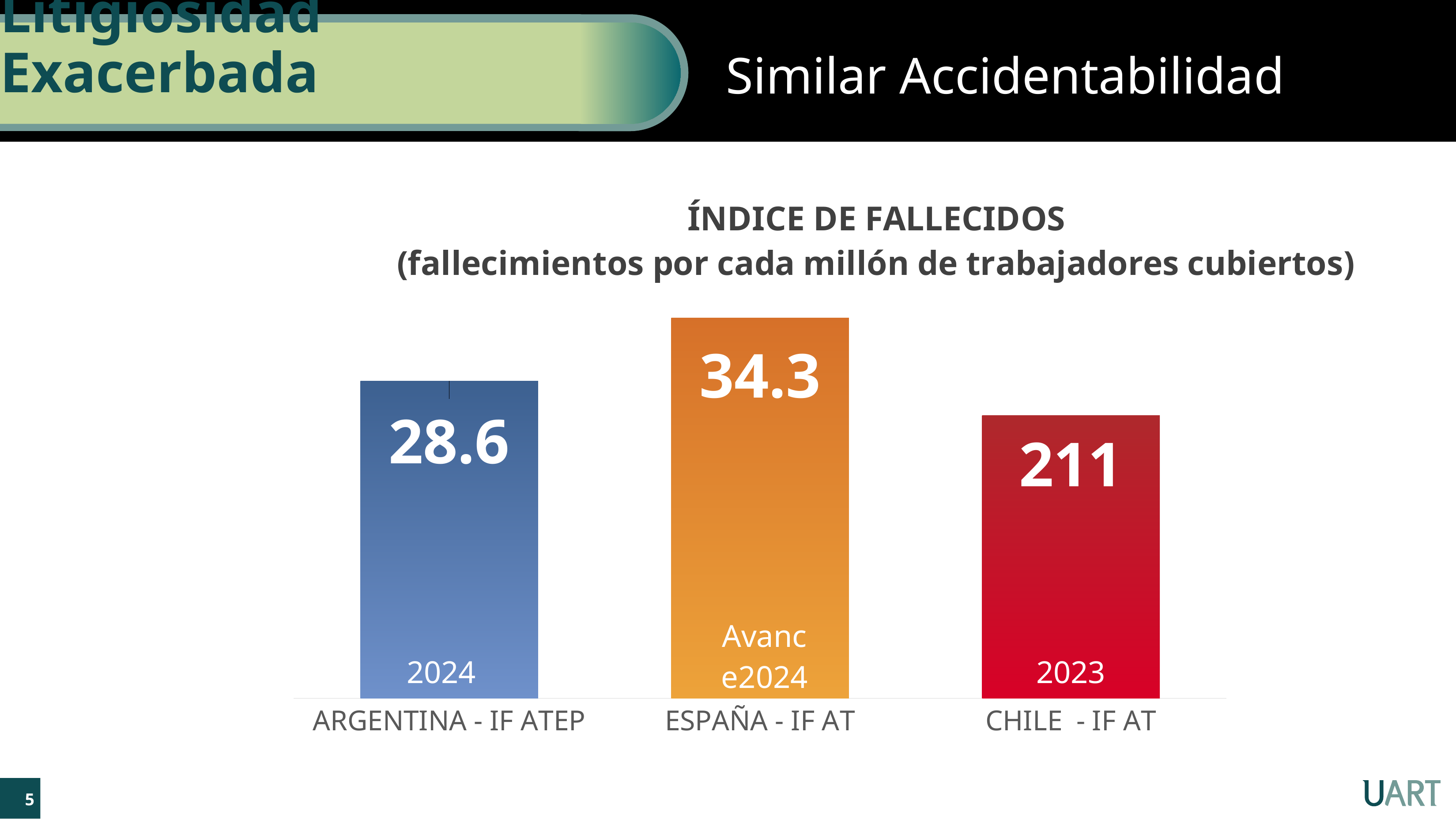
How many bars are shown in the chart? 3 What is the value shown for ESPAÑA - IF AT? 34.3 What is the difference between the values for ESPAÑA - IF AT and ARGENTINA - IF ATEP? 5.7 Which has the larger value, ARGENTINA - IF ATEP or ESPAÑA - IF AT? ESPAÑA - IF AT What year label is printed on the ARGENTINA - IF ATEP bar? 2024 What kind of chart is shown on the slide? Bar chart What value is printed on the CHILE - IF AT bar? 211 What is the title of the chart? ÍNDICE DE FALLECIDOS (fallecimientos por cada millón de trabajadores cubiertos) What is the value shown for ARGENTINA - IF ATEP? 28.6